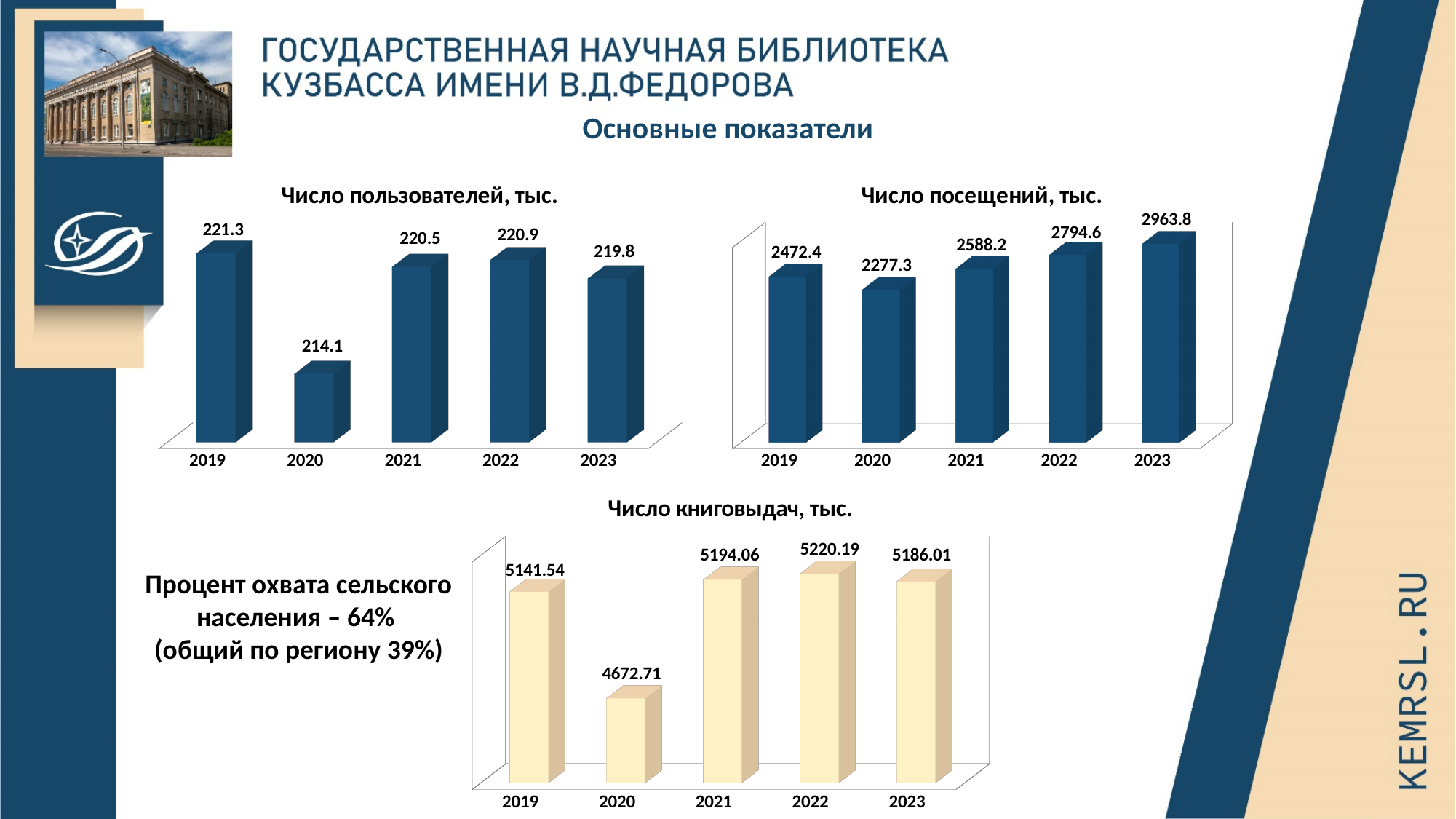
In the chart 'Число посещений, тыс.', do the values rise or fall from 2020 to 2023? rise In the chart 'Число книговыдач, тыс.', what is the difference between the 2022 and 2020 values? 547.48 In the chart 'Число посещений, тыс.', which year has the lowest value? 2020 In the chart 'Число посещений, тыс.', what is the value for 2022? 2794.6 In the chart 'Число книговыдач, тыс.', which is larger, the value for 2019 or the value for 2023? 2023 In the chart 'Число пользователей, тыс.', what is the difference between the 2019 and 2020 values? 7.2 In the chart 'Число пользователей, тыс.', which year has the highest value? 2019 In the chart 'Число книговыдач, тыс.', which year has the highest value? 2022 In the chart 'Число посещений, тыс.', what is the difference between the 2023 and 2019 values? 491.4 In the chart 'Число пользователей, тыс.', what is the value for 2020? 214.1 How many years are shown in the chart 'Число пользователей, тыс.'? 5 In the chart 'Число книговыдач, тыс.', what is the value for 2021? 5194.06